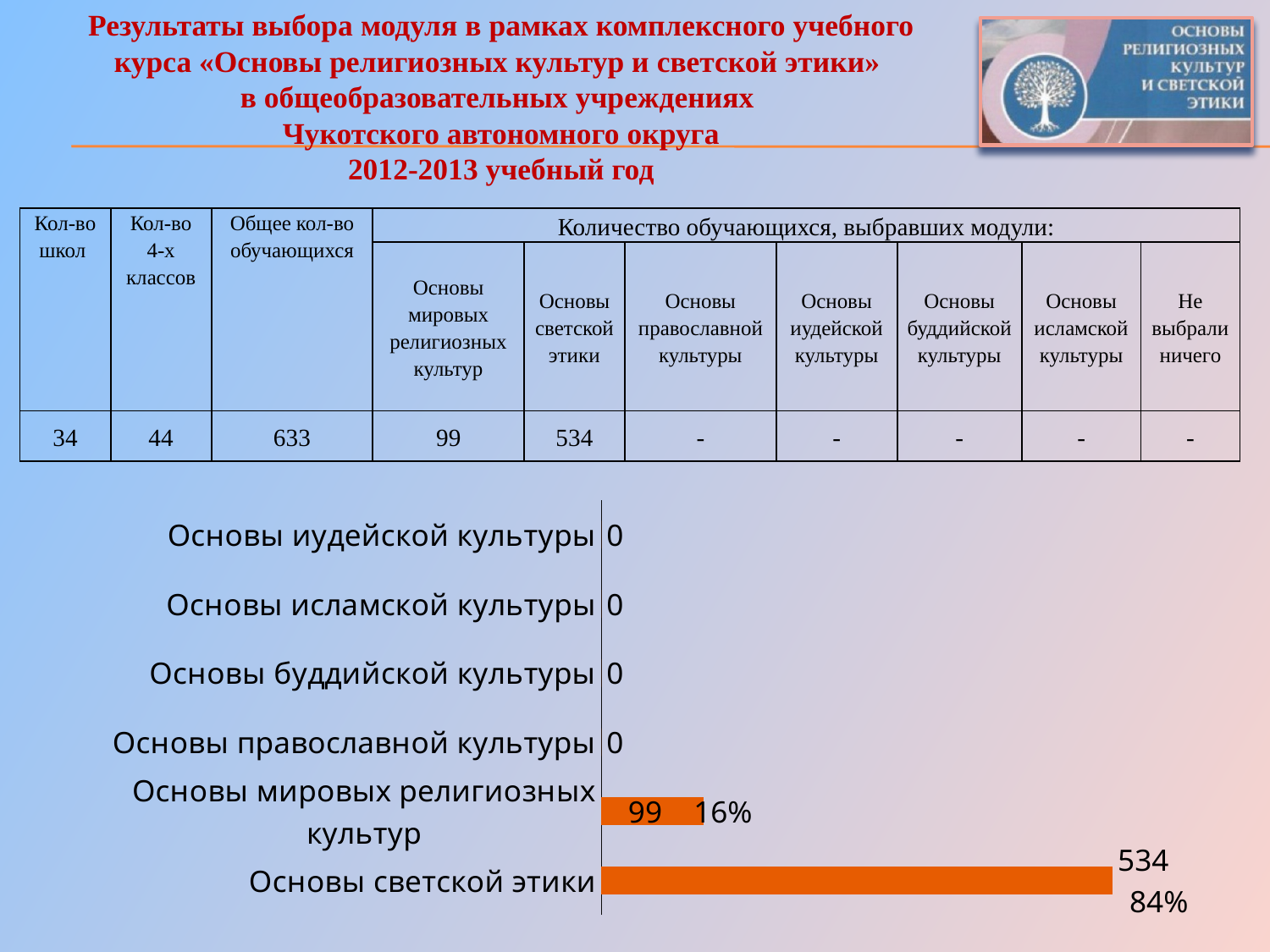
Which is larger: the value for Основы светской этики or the value for Основы мировых религиозных культур? Основы светской этики What colour are the bars in the chart? orange How many categories in the bar chart have a value of 0? 4 Which category has the highest value in the bar chart? Основы светской этики What percentage is shown next to the bar for Основы светской этики? 84% What kind of chart is shown on the slide? bar chart What is the difference between the values for Основы светской этики and Основы мировых религиозных культур? 435 What value is shown for Основы мировых религиозных культур in the bar chart? 99 How many categories are shown in the bar chart? 6 What value is shown for Основы светской этики in the bar chart? 534 What percentage is shown next to the bar for Основы мировых религиозных культур? 16% What value is shown for Основы православной культуры in the bar chart? 0